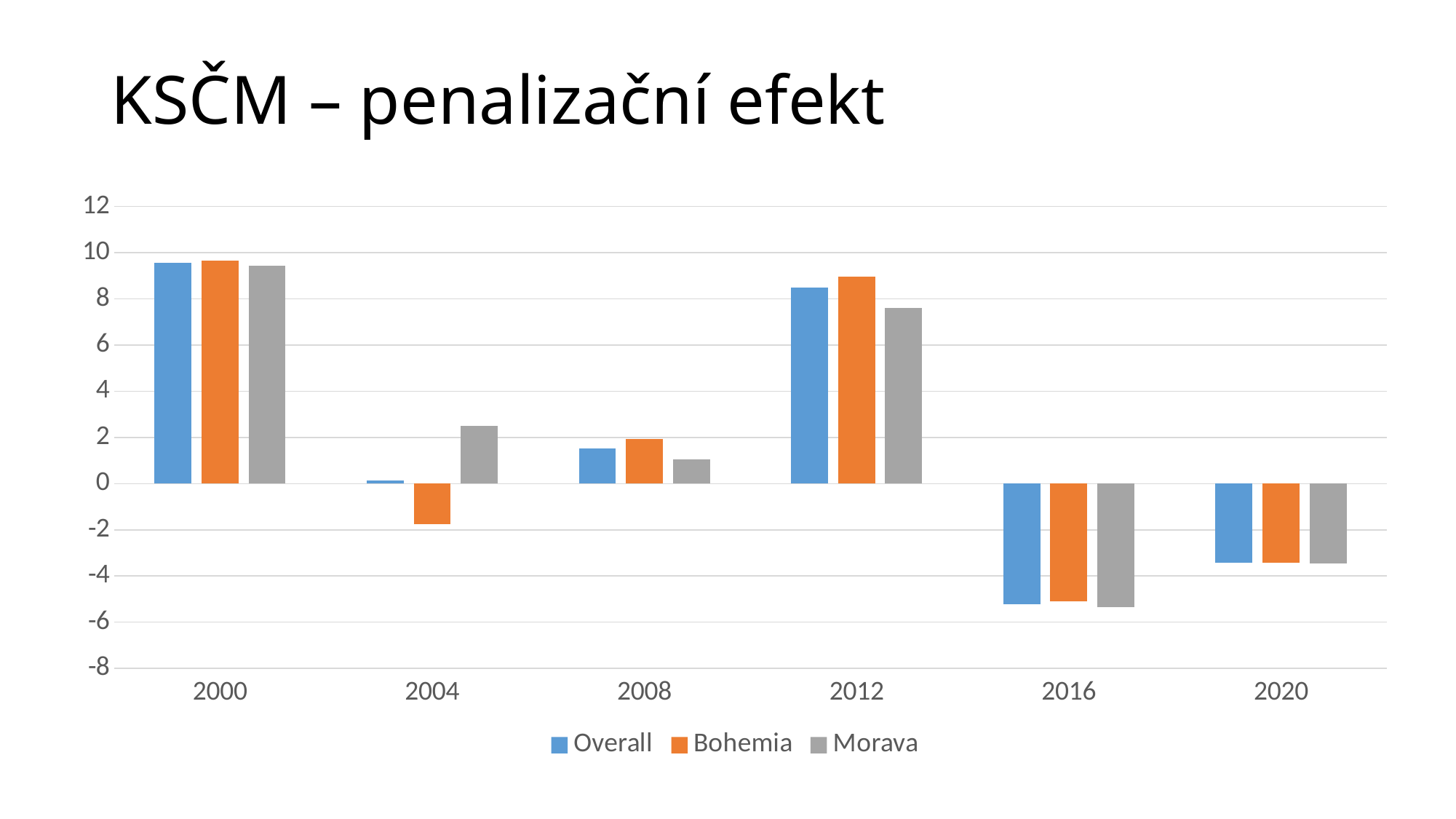
Does the Overall value rise or fall from 2012 to 2016? fall What kind of chart is shown on the slide? bar chart How many years are shown on the x axis? 6 In 2012, which is larger: the Bohemia value or the Morava value? Bohemia In which year is the Morava value highest? 2000 Is the Bohemia value for 2004 greater or less than 0? less Is the Overall value for 2000 greater or less than 8? greater What is the title of the slide? KSČM – penalizační efekt Is the Morava value for 2012 greater or less than 8? less In 2004, which is larger: the Bohemia value or the Morava value? Morava How many series does the legend list? 3 In which year is the Overall value lowest? 2016